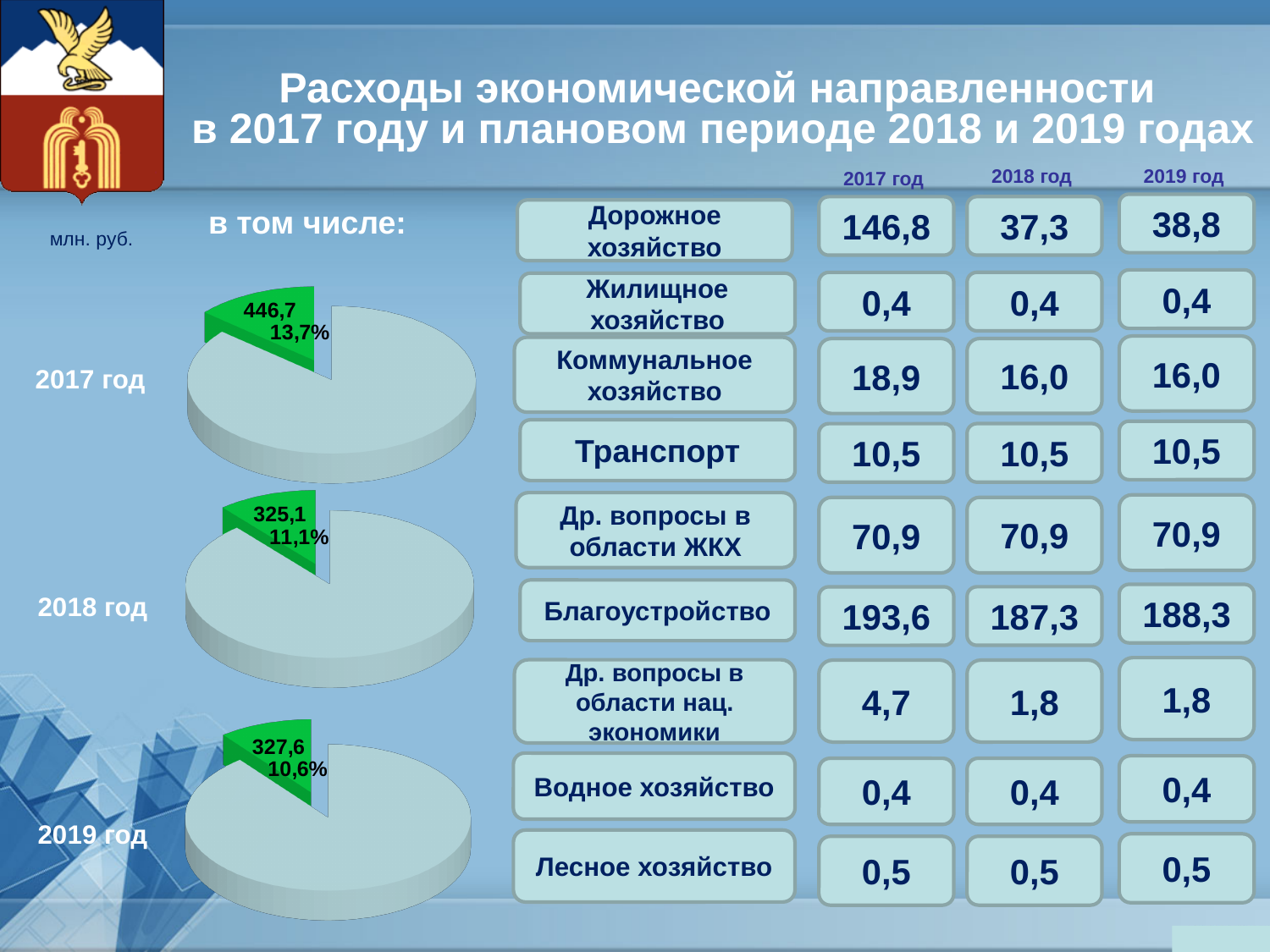
In the 2017 год pie chart, what share of the pie does the highlighted green slice represent? 13,7% What is the difference between the highlighted slice values in the 2017 год and 2018 год pie charts? 121,6 How many pie charts are on the slide? 3 What type of charts are shown on the left side of the slide? Pie charts In the 2018 год pie chart, what value is printed on the highlighted green slice? 325,1 In the 2019 год pie chart, what value is printed on the highlighted green slice? 327,6 In the 2019 год pie chart, what share of the pie does the highlighted green slice represent? 10,6% In the 2017 год pie chart, what value is printed on the highlighted green slice? 446,7 Which year's pie chart has the largest highlighted slice value? 2017 год In the 2018 год pie chart, what share of the pie does the highlighted green slice represent? 11,1% Which year's pie chart has the smallest highlighted slice share? 2019 год What colour is the highlighted slice in each of the pie charts? Green